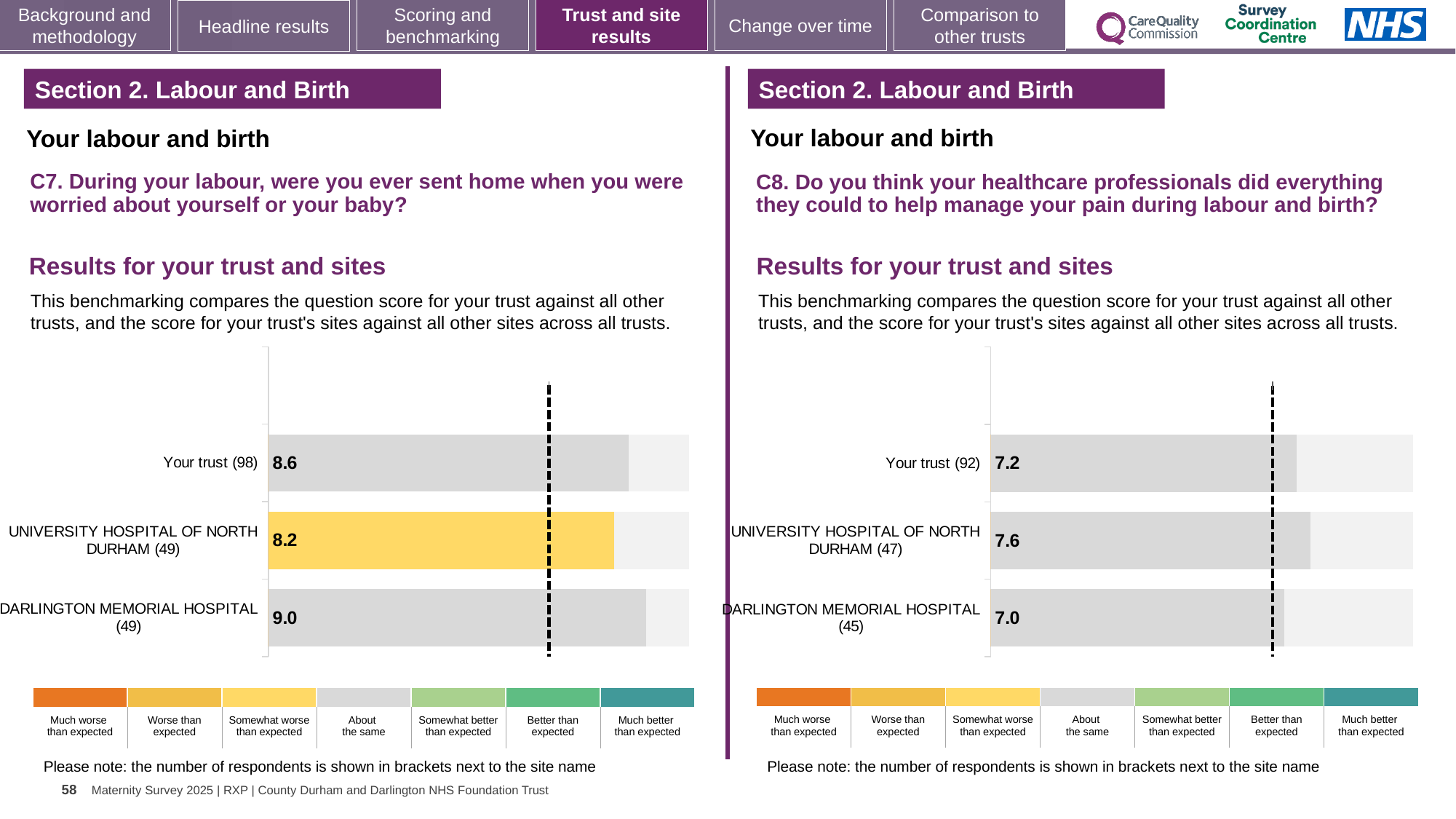
In the C7 chart on the left, what is the score for Your trust? 8.6 In the C8 chart on the right, what is the score for Your trust? 7.2 In the C7 chart on the left, how many bars are plotted? 3 In the C7 chart on the left, which bar is coloured yellow? University Hospital of North Durham In the C7 chart on the left, which site or trust has the lowest score? University Hospital of North Durham In the C7 chart on the left, what is the score for Darlington Memorial Hospital? 9.0 In the C8 chart on the right, what is the difference between the scores for University Hospital of North Durham and Darlington Memorial Hospital? 0.6 In the C8 chart on the right, which site or trust has the highest score? University Hospital of North Durham What kind of chart is used on the left for question C7? Bar chart In the C8 chart on the right, is the score for Your trust larger or smaller than the score for Darlington Memorial Hospital? larger In the C7 chart on the left, what is the difference between the scores for Darlington Memorial Hospital and University Hospital of North Durham? 0.8 In the C8 chart on the right, what is the score for University Hospital of North Durham? 7.6